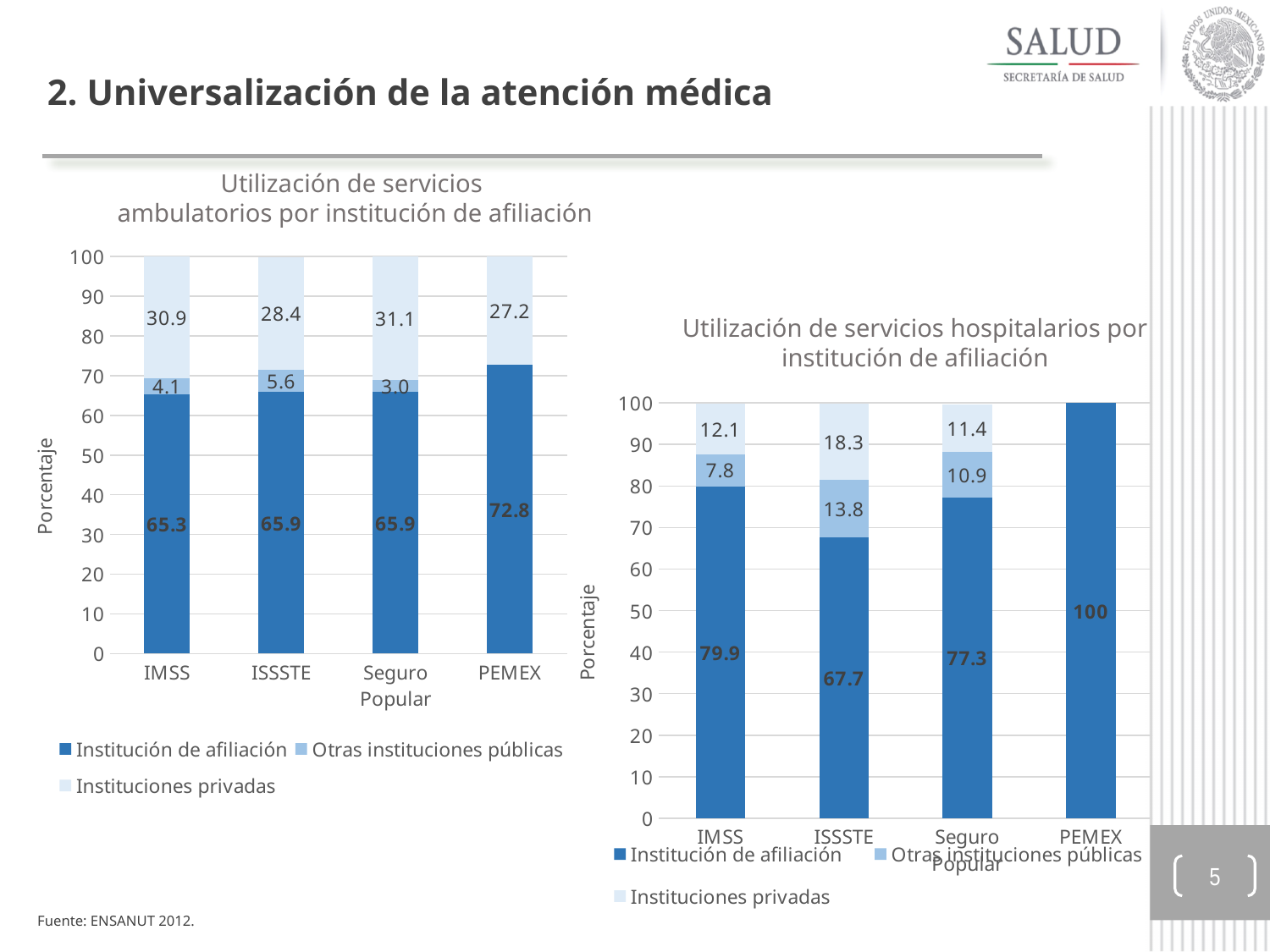
In the chart titled 'Utilización de servicios hospitalarios por institución de afiliación', what is the value for 'Institución de afiliación' for ISSSTE? 67.7 In the chart titled 'Utilización de servicios ambulatorios por institución de afiliación', what is the value for 'Instituciones privadas' for IMSS? 30.9 In the chart titled 'Utilización de servicios ambulatorios por institución de afiliación', what is the value for 'Institución de afiliación' for PEMEX? 72.8 In the chart titled 'Utilización de servicios ambulatorios por institución de afiliación', which institution has the lowest value for 'Otras instituciones públicas' among those with a printed label? Seguro Popular In the chart titled 'Utilización de servicios hospitalarios por institución de afiliación', what is the value for 'Otras instituciones públicas' for Seguro Popular? 10.9 In the chart titled 'Utilización de servicios ambulatorios por institución de afiliación', what is the difference between the 'Instituciones privadas' values for Seguro Popular and PEMEX? 3.9 In the chart titled 'Utilización de servicios hospitalarios por institución de afiliación', is the 'Institución de afiliación' value for IMSS or for Seguro Popular larger? IMSS What kind of chart is the chart titled 'Utilización de servicios ambulatorios por institución de afiliación'? Stacked bar chart In the chart titled 'Utilización de servicios ambulatorios por institución de afiliación', which institution has the highest value for 'Institución de afiliación'? PEMEX In the chart titled 'Utilización de servicios ambulatorios por institución de afiliación', what is the value for 'Otras instituciones públicas' for ISSSTE? 5.6 How many series does the legend list in the chart titled 'Utilización de servicios hospitalarios por institución de afiliación'? 3 In the chart titled 'Utilización de servicios hospitalarios por institución de afiliación', which institution has the highest value for 'Instituciones privadas'? ISSSTE